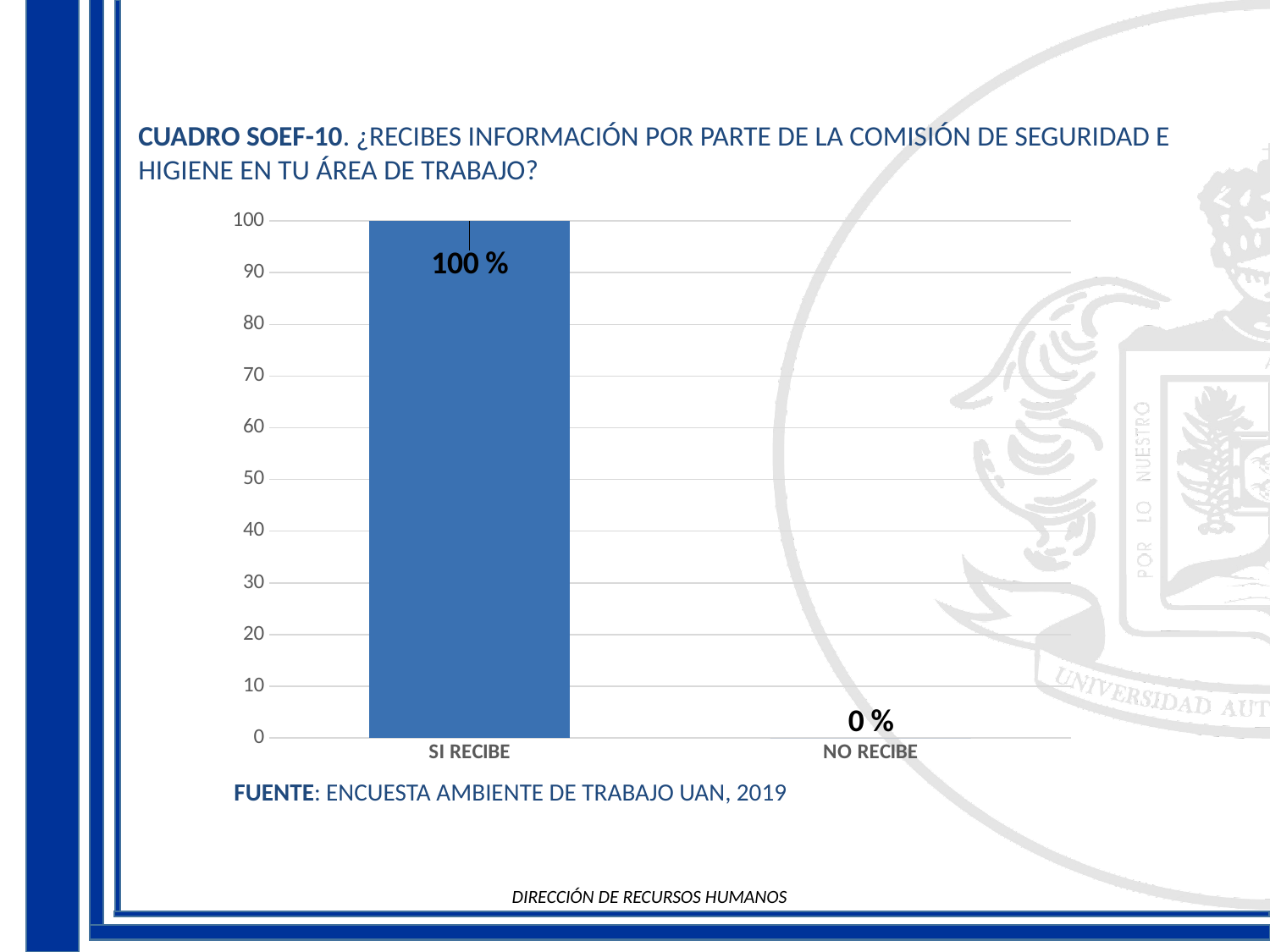
What is the source cited below the chart? ENCUESTA AMBIENTE DE TRABAJO UAN, 2019 What is the value for SI RECIBE? 100 % What is the difference between the values for SI RECIBE and NO RECIBE? 100 % Which category has the highest value? SI RECIBE Which is larger, the value for SI RECIBE or the value for NO RECIBE? SI RECIBE What kind of chart is shown on the slide? bar chart Is the value for SI RECIBE greater or less than 50? greater What is the total of the values for SI RECIBE and NO RECIBE? 100 % Which category has the lowest value? NO RECIBE How many categories are shown on the x axis? 2 What is the value for NO RECIBE? 0 % What is the highest tick value shown on the vertical axis? 100